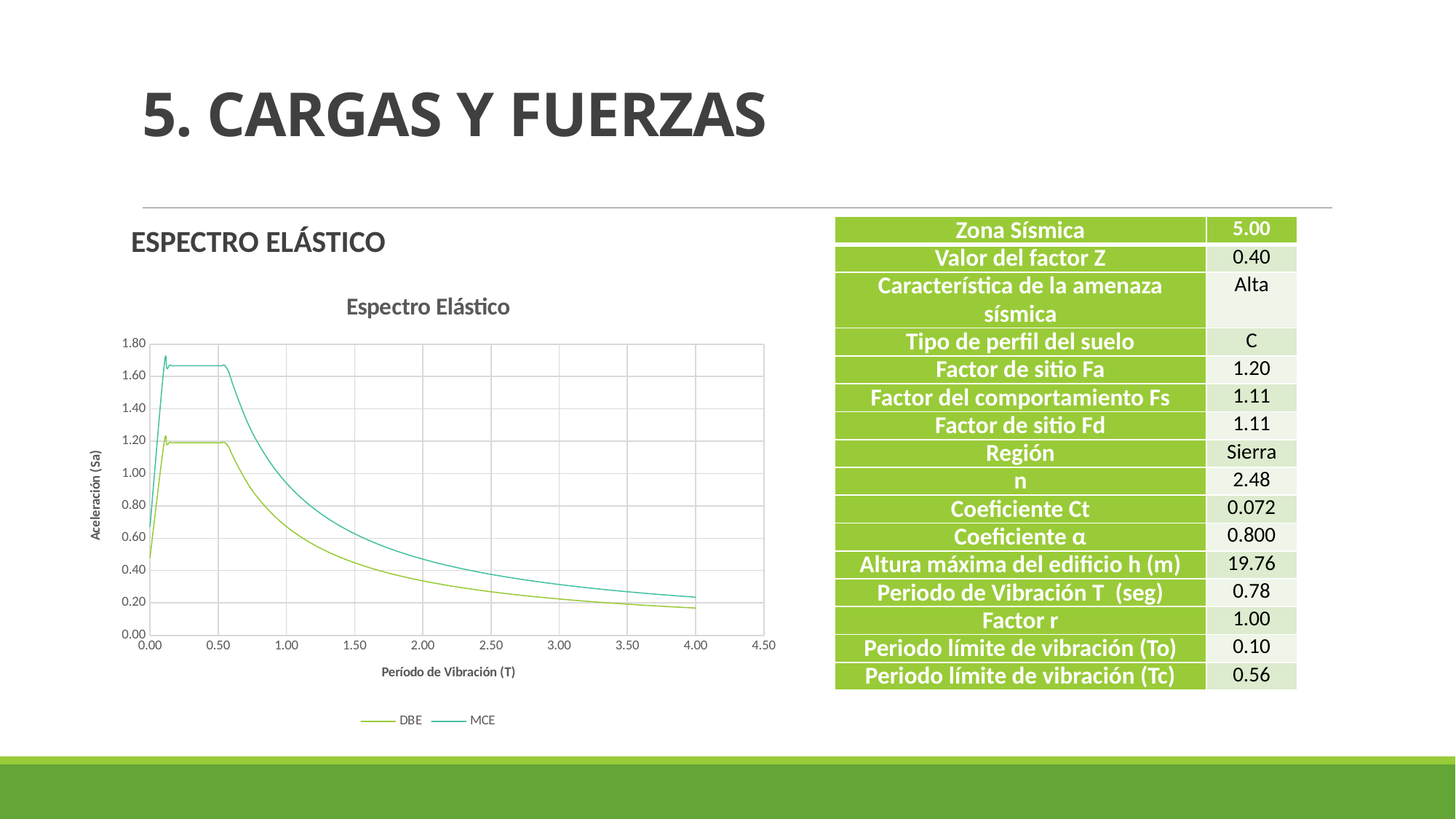
In the 'Espectro Elástico' chart, is the plateau value of the MCE series greater or less than 1.60? greater What kind of chart is the 'Espectro Elástico' chart? line chart In the 'Espectro Elástico' chart, is the value of the MCE series at a period of 2.00 greater or less than 0.40? greater In the 'Espectro Elástico' chart, which series is plotted in the lighter green line? DBE What is the label of the x axis of the 'Espectro Elástico' chart? Período de Vibración (T) In the 'Espectro Elástico' chart, which series has the higher value at a period of 1.00, DBE or MCE? MCE In the 'Espectro Elástico' chart, do the values of the MCE series rise or fall as the period increases from 1.00 to 4.00? fall In the 'Espectro Elástico' chart, is the value of the DBE series at a period of 2.00 greater or less than 0.40? less How many series does the legend of the 'Espectro Elástico' chart list? 2 What are the names of the series in the legend of the 'Espectro Elástico' chart? DBE and MCE